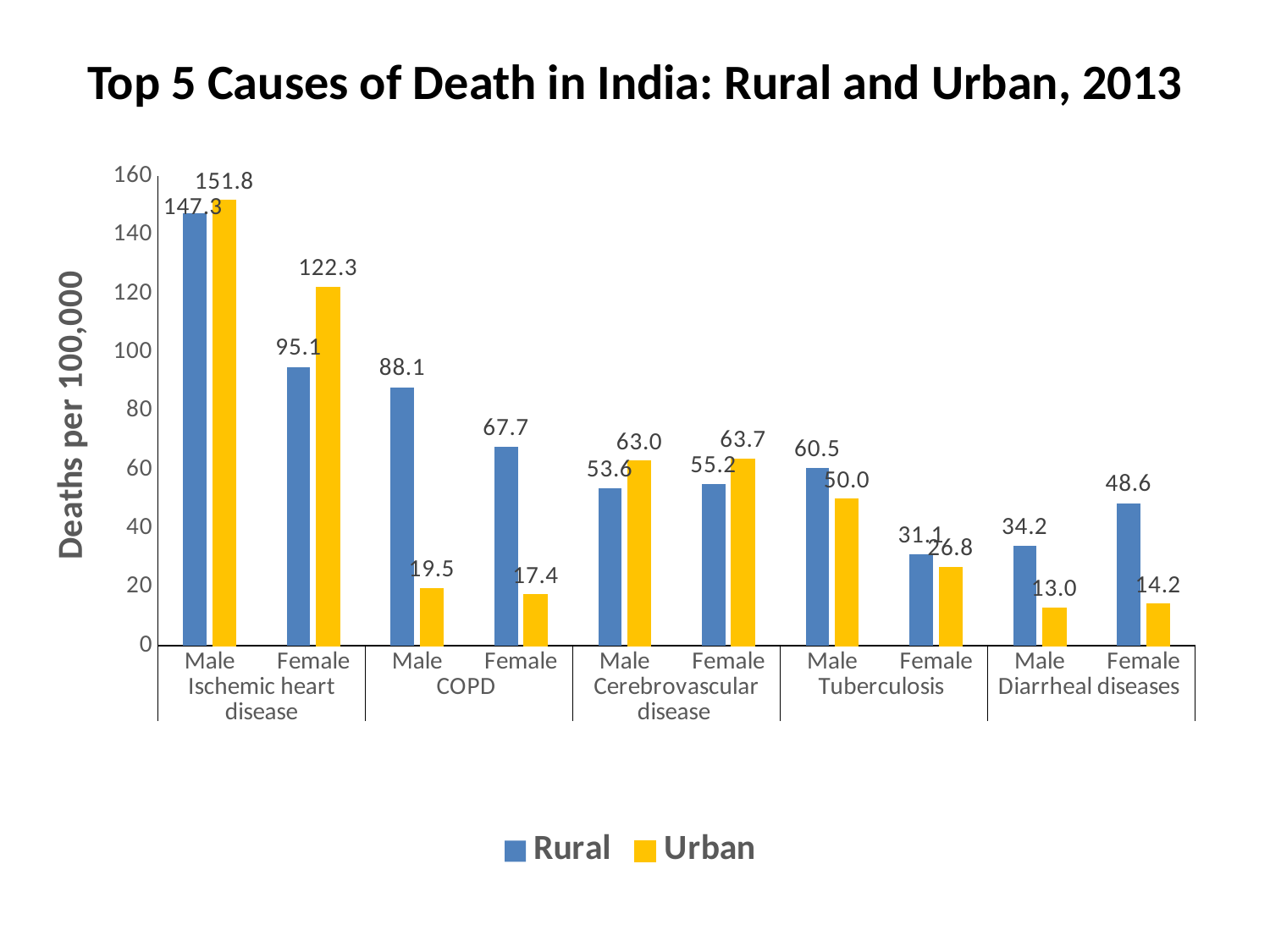
What is the difference between the rural and urban death rates for males from COPD? 68.6 Which bar has the highest value on the chart? Urban, Male, Ischemic heart disease (151.8) What is the urban death rate for males from diarrheal diseases? 13.0 What is the rural death rate for males from COPD? 88.1 Which bar has the lowest value on the chart? Urban, Male, Diarrheal diseases (13.0) For males with tuberculosis, is the rural or urban death rate higher? Rural What is the rural death rate for females from tuberculosis? 31.1 How many series does the legend list? 2 What is the label on the vertical axis? Deaths per 100,000 What is the difference between the urban and rural death rates for females from ischemic heart disease? 27.2 What is the urban death rate for females from ischemic heart disease? 122.3 What type of chart is shown on the slide? Bar chart